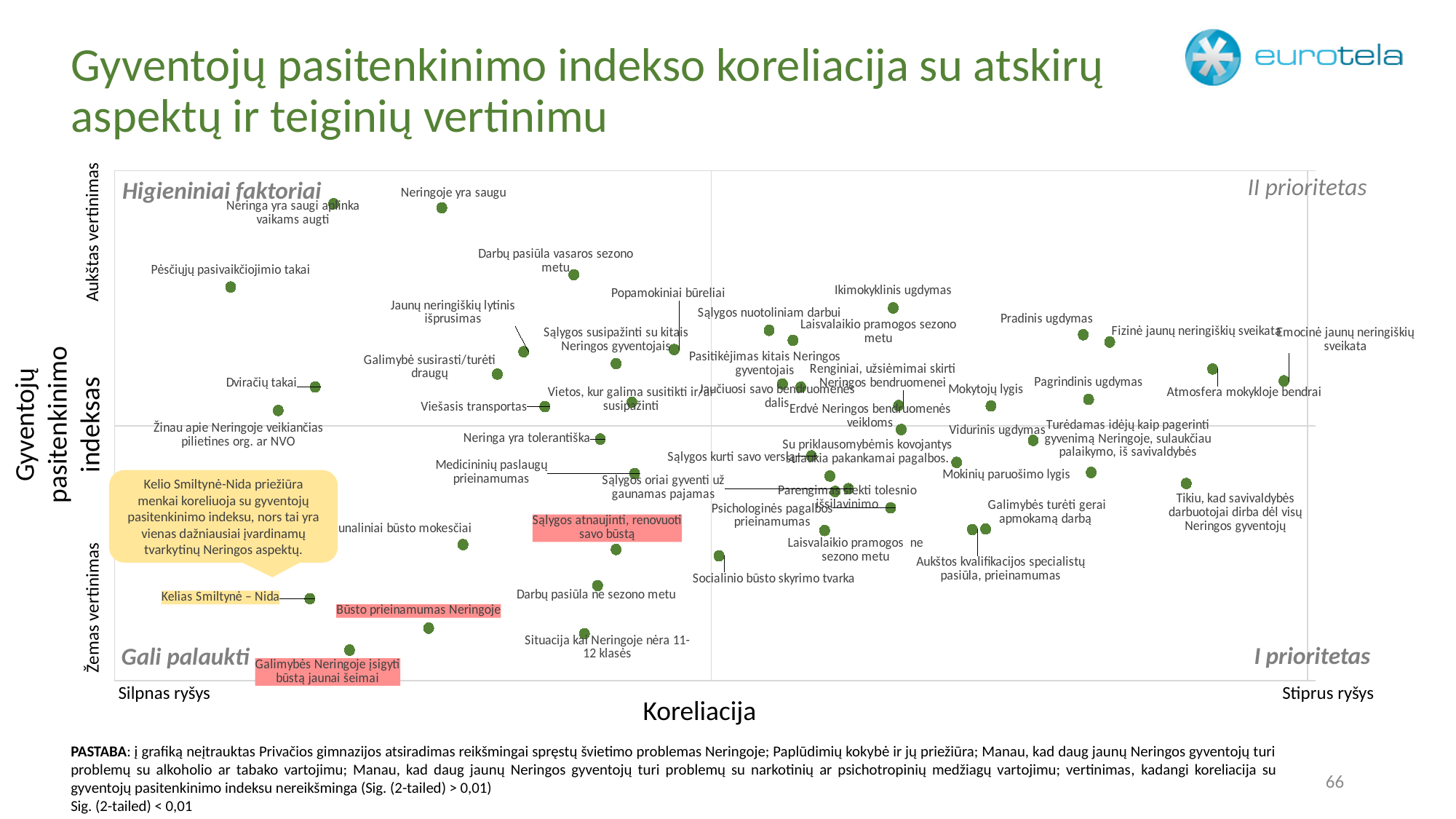
Which is plotted higher on the satisfaction axis: "Pėsčiųjų pasivaikščiojimo takai" or "Dviračių takai"? Pėsčiųjų pasivaikščiojimo takai Which item is plotted lowest on the chart (lowest satisfaction rating)? Galimybės Neringoje įsigyti būstą jaunai šeimai In which quadrant of the chart is "Kelias Smiltynė – Nida" plotted? Gali palaukti Which item is plotted furthest to the left (weakest correlation) on the chart? Pėsčiųjų pasivaikščiojimo takai In which quadrant of the chart is "Atmosfera mokykloje bendrai" plotted? II prioritetas In which quadrant of the chart is "Neringoje yra saugu" plotted? Higieniniai faktoriai Which is plotted further to the right (stronger correlation): "Ikimokyklinis ugdymas" or "Pradinis ugdymas"? Pradinis ugdymas Which is plotted higher on the satisfaction axis: "Pradinis ugdymas" or "Mokinių paruošimo lygis"? Pradinis ugdymas What is the label of the horizontal axis of the chart? Koreliacija Which quadrant label appears in the bottom-right corner of the chart? I prioritetas What kind of chart is shown on the slide? Scatter chart Which item is plotted furthest to the right (strongest correlation) on the chart? Emocinė jaunų neringiškių sveikata